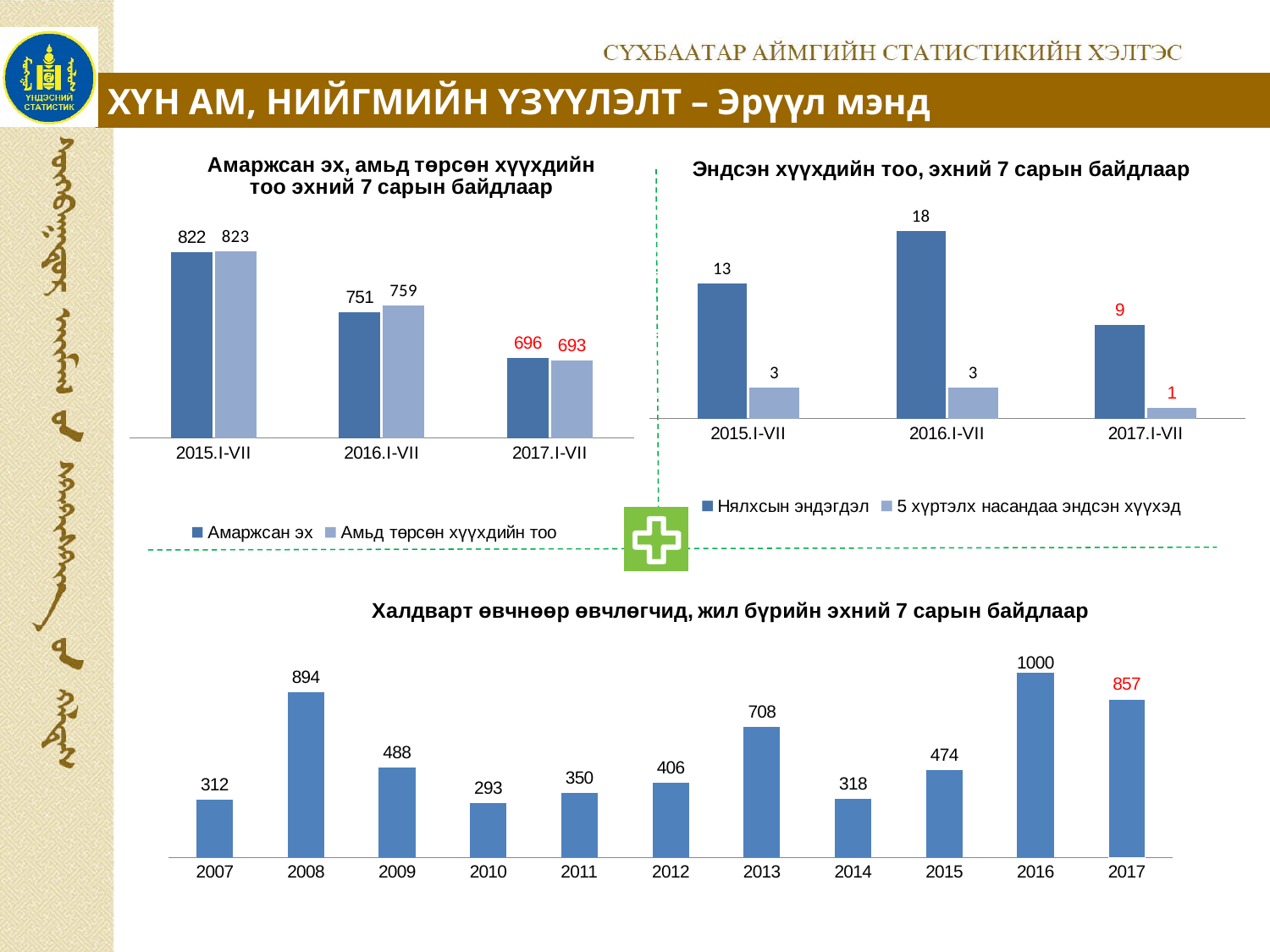
In the bottom chart (Халдварт өвчнөөр өвчлөгчид), which year has the highest value? 2016 In the top-left chart (Амаржсан эх, амьд төрсөн хүүхдийн тоо), how many series does the legend list? 2 In the top-left chart (Амаржсан эх, амьд төрсөн хүүхдийн тоо), what is the difference between Амьд төрсөн хүүхдийн тоо and Амаржсан эх in 2016.I-VII? 8 In the bottom chart (Халдварт өвчнөөр өвчлөгчид), how many years are shown on the x axis? 11 In the top-left chart (Амаржсан эх, амьд төрсөн хүүхдийн тоо), what is the value for Амьд төрсөн хүүхдийн тоо in 2015.I-VII? 823 In the bottom chart (Халдварт өвчнөөр өвчлөгчид), what is the difference between the values for 2016 and 2017? 143 In the bottom chart (Халдварт өвчнөөр өвчлөгчид), which year has the lowest value? 2010 In the top-left chart (Амаржсан эх, амьд төрсөн хүүхдийн тоо), what is the value for Амаржсан эх in 2017.I-VII? 696 In the top-right chart (Эндсэн хүүхдийн тоо), what is the value for Нялхсын эндэгдэл in 2016.I-VII? 18 In the top-right chart (Эндсэн хүүхдийн тоо), what is the difference between Нялхсын эндэгдэл and 5 хүртэлх насандаа эндсэн хүүхэд in 2015.I-VII? 10 In the top-right chart (Эндсэн хүүхдийн тоо), which period has the lowest value for 5 хүртэлх насандаа эндсэн хүүхэд? 2017.I-VII In the top-left chart (Амаржсан эх, амьд төрсөн хүүхдийн тоо), do the values for Амаржсан эх rise or fall from 2015.I-VII to 2017.I-VII? fall